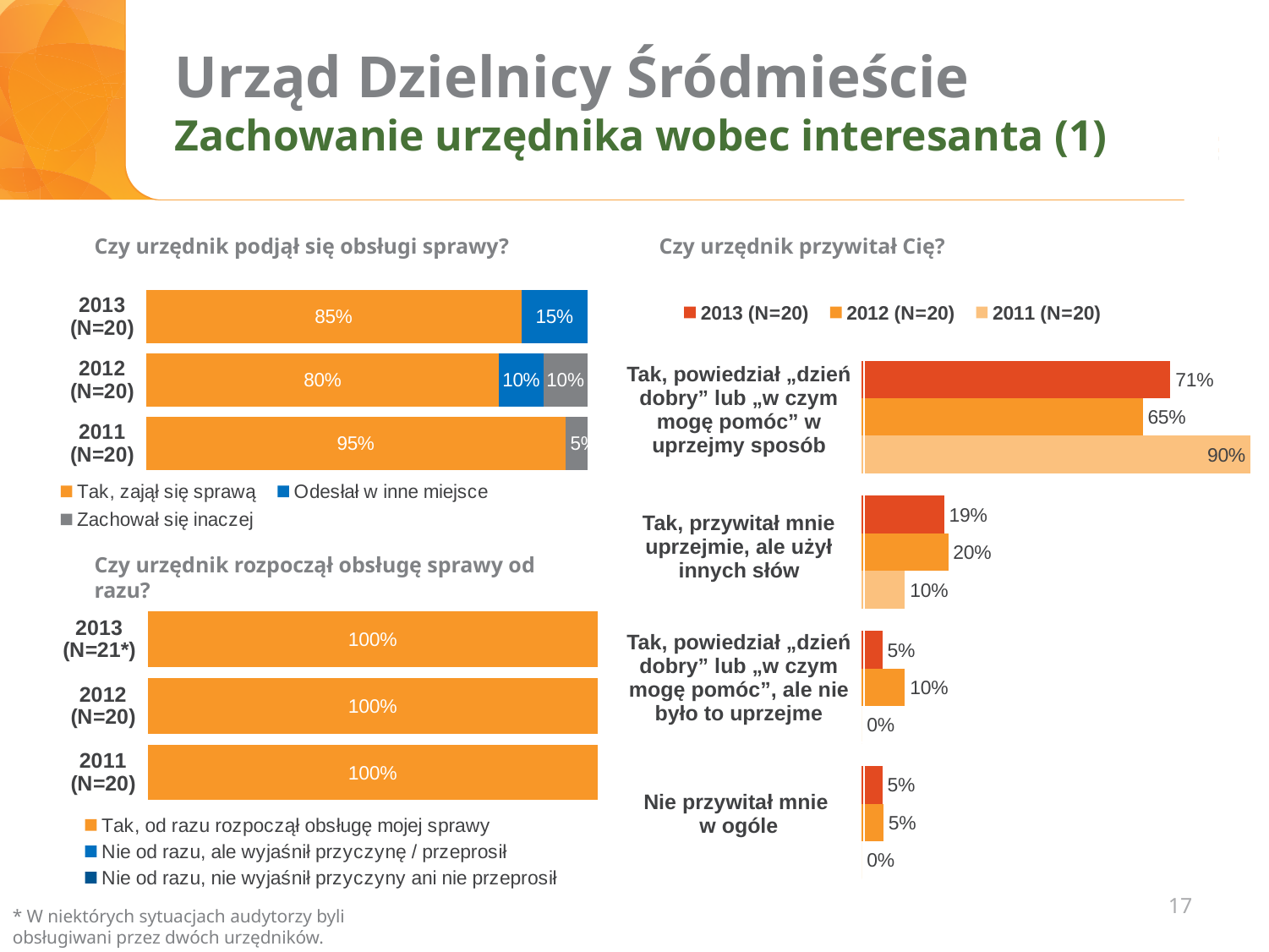
In the chart "Czy urzędnik przywitał Cię?", which is larger for "Tak, powiedział „dzień dobry” lub „w czym mogę pomóc” w uprzejmy sposób": the 2013 (N=20) value or the 2012 (N=20) value? 2013 (N=20) In the chart "Czy urzędnik rozpoczął obsługę sprawy od razu?", what is the value for "Tak, od razu rozpoczął obsługę mojej sprawy" in 2012 (N=20)? 100% In the chart "Czy urzędnik podjął się obsługi sprawy?", what is the value for "Odesłał w inne miejsce" in 2012 (N=20)? 10% In the chart "Czy urzędnik rozpoczął obsługę sprawy od razu?", how many years are shown? 3 In the chart "Czy urzędnik podjął się obsługi sprawy?", what is the value for "Tak, zajął się sprawą" in 2013 (N=20)? 85% In the chart "Czy urzędnik podjął się obsługi sprawy?", how many series does the legend list? 3 In the chart "Czy urzędnik przywitał Cię?", what is the 2011 (N=20) value for "Tak, powiedział „dzień dobry” lub „w czym mogę pomóc” w uprzejmy sposób"? 90% In the chart "Czy urzędnik podjął się obsługi sprawy?", which year has the highest value for "Tak, zajął się sprawą"? 2011 (N=20) In the chart "Czy urzędnik podjął się obsługi sprawy?", what is the difference between the "Tak, zajął się sprawą" values for 2011 and 2012? 15% What kind of chart is "Czy urzędnik przywitał Cię?"? Bar chart In the chart "Czy urzędnik przywitał Cię?", what is the difference between the 2011 (N=20) and 2012 (N=20) values for "Tak, powiedział „dzień dobry” lub „w czym mogę pomóc” w uprzejmy sposób"? 25% In the chart "Czy urzędnik przywitał Cię?", what is the 2013 (N=20) value for "Tak, przywitał mnie uprzejmie, ale użył innych słów"? 19%